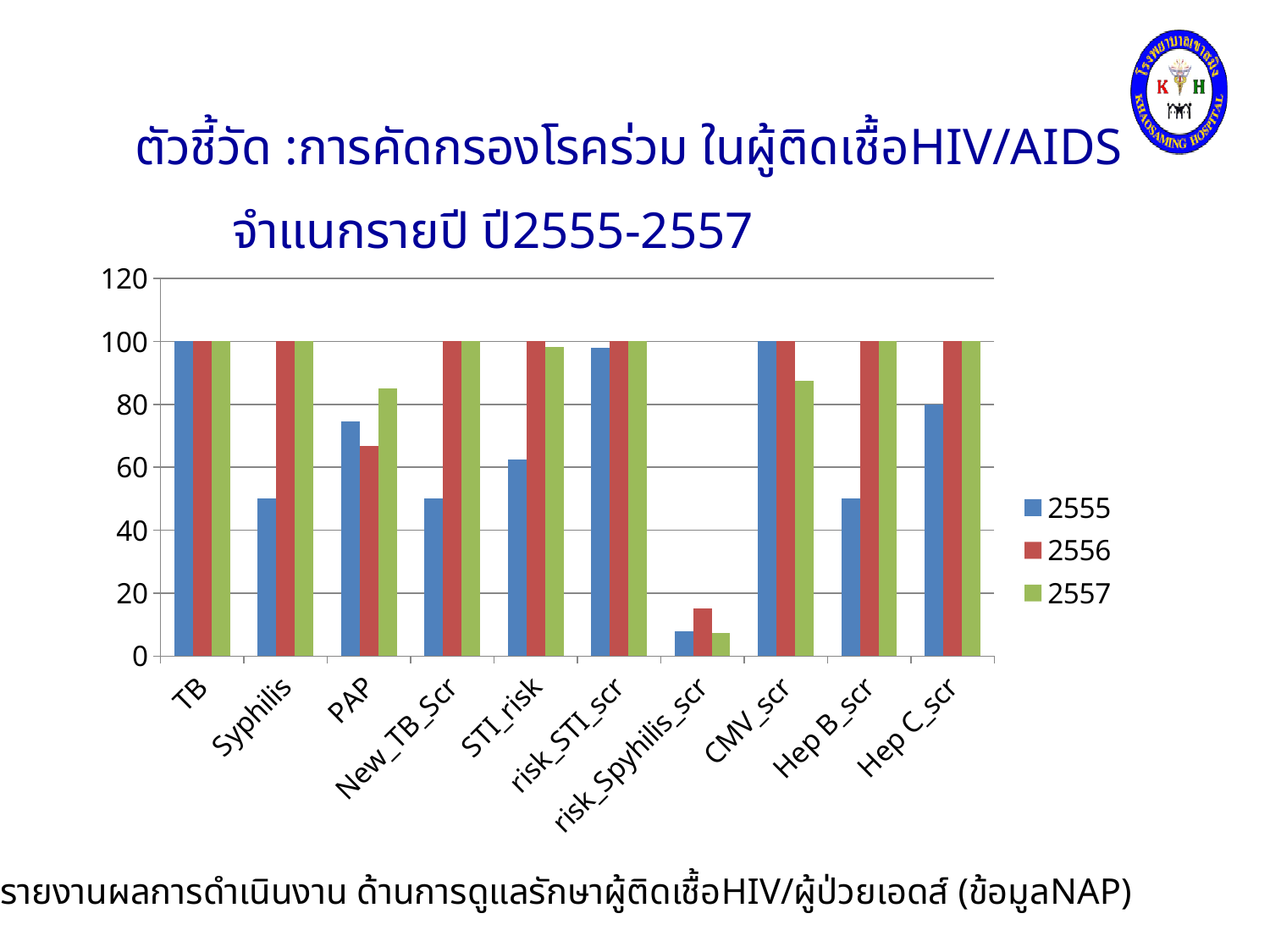
How many categories are shown on the x axis? 10 Is the value for Syphilis in series 2555 greater or less than 60? less Is the value for risk_Spyhilis_scr in series 2556 greater or less than 20? less What is the value for Syphilis in series 2556? 100 What kind of chart is shown on the slide? bar chart What are the entries listed in the legend? 2555, 2556, 2557 What is the value for Hep C_scr in series 2555? 80 For PAP, which series has the larger value: 2555 or 2556? 2555 How many series does the legend list? 3 Which category has the lowest values across all three series? risk_Spyhilis_scr Is the value for PAP in series 2557 greater or less than 80? greater What is the value for TB in series 2555? 100